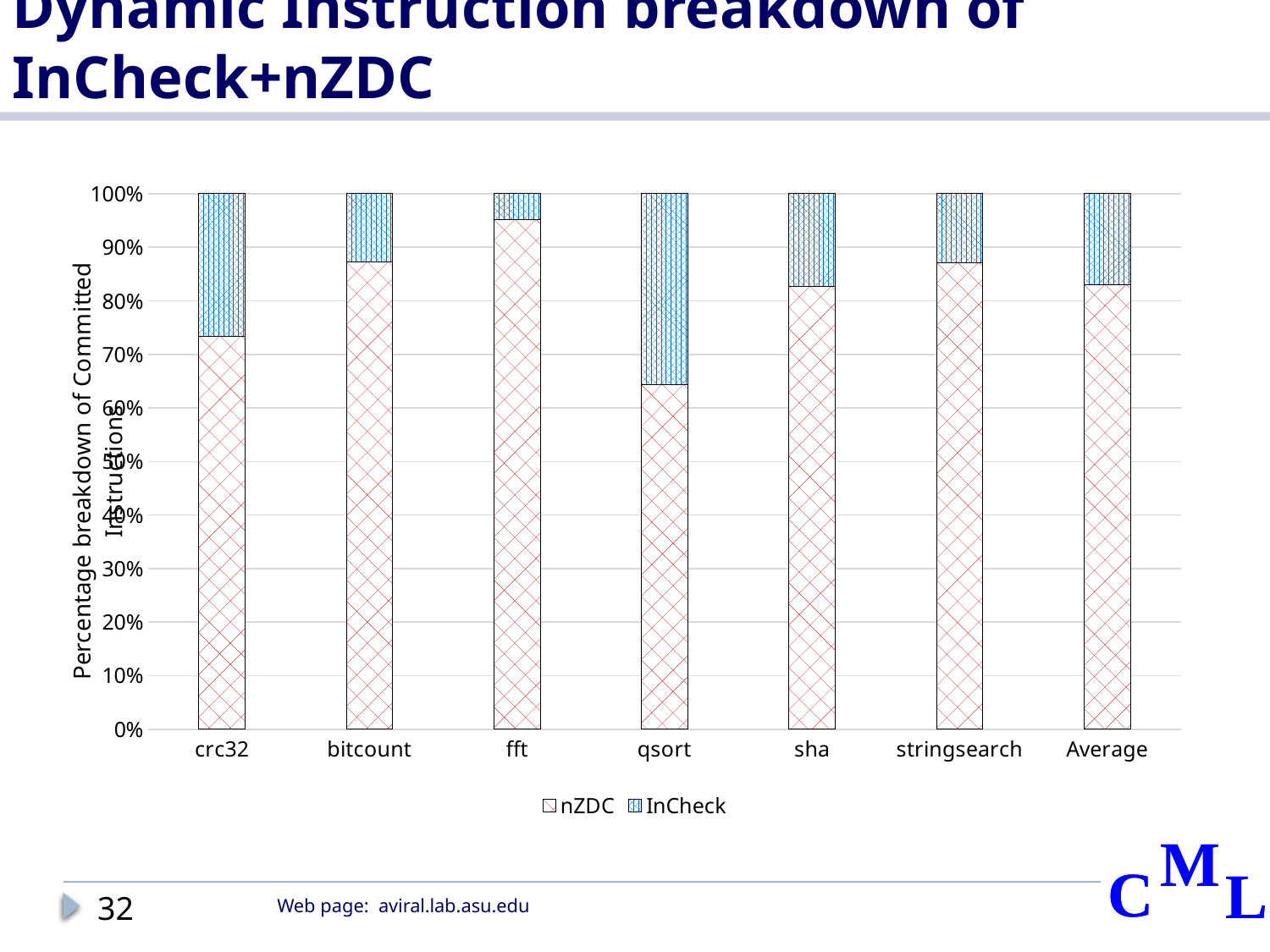
How many series does the chart's legend list? 2 What kind of chart is shown on the slide? Stacked bar chart Is the nZDC share for fft greater or less than 90%? greater Is the nZDC share for crc32 greater or less than 70%? greater What is the total of the stacked bar for Average? 100% Which category has the smallest nZDC share of committed instructions? qsort What are the two series named in the chart's legend? nZDC and InCheck Which category has the largest nZDC share of committed instructions? fft Which category has the largest InCheck share of committed instructions? qsort How many categories are shown along the x axis of the chart? 7 Which has a larger nZDC share, crc32 or qsort? crc32 Is the nZDC share for qsort greater or less than 70%? less